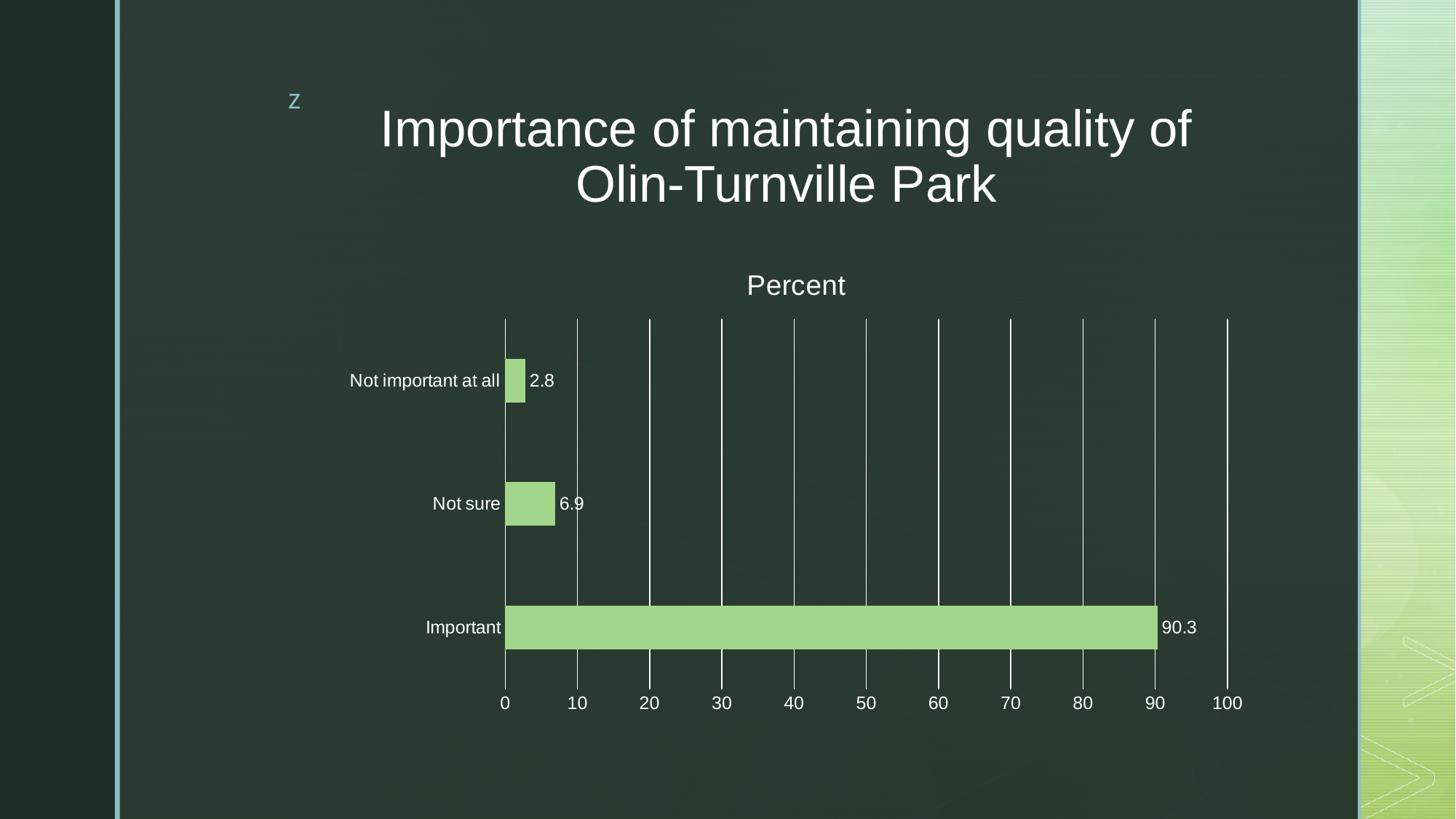
Which is larger, the value for Not sure or the value for Not important at all? Not sure Which category has the highest value? Important What kind of chart is shown on the slide? bar chart Is the value for Important greater or less than 80? greater What is the difference between the values for Important and Not sure? 83.4 How many categories are shown in the chart? 3 What is the value for Not important at all? 2.8 What is the value for Not sure? 6.9 What is the difference between the values for Not sure and Not important at all? 4.1 What is the title of the chart? Percent What is the value for Important? 90.3 Which category has the lowest value? Not important at all